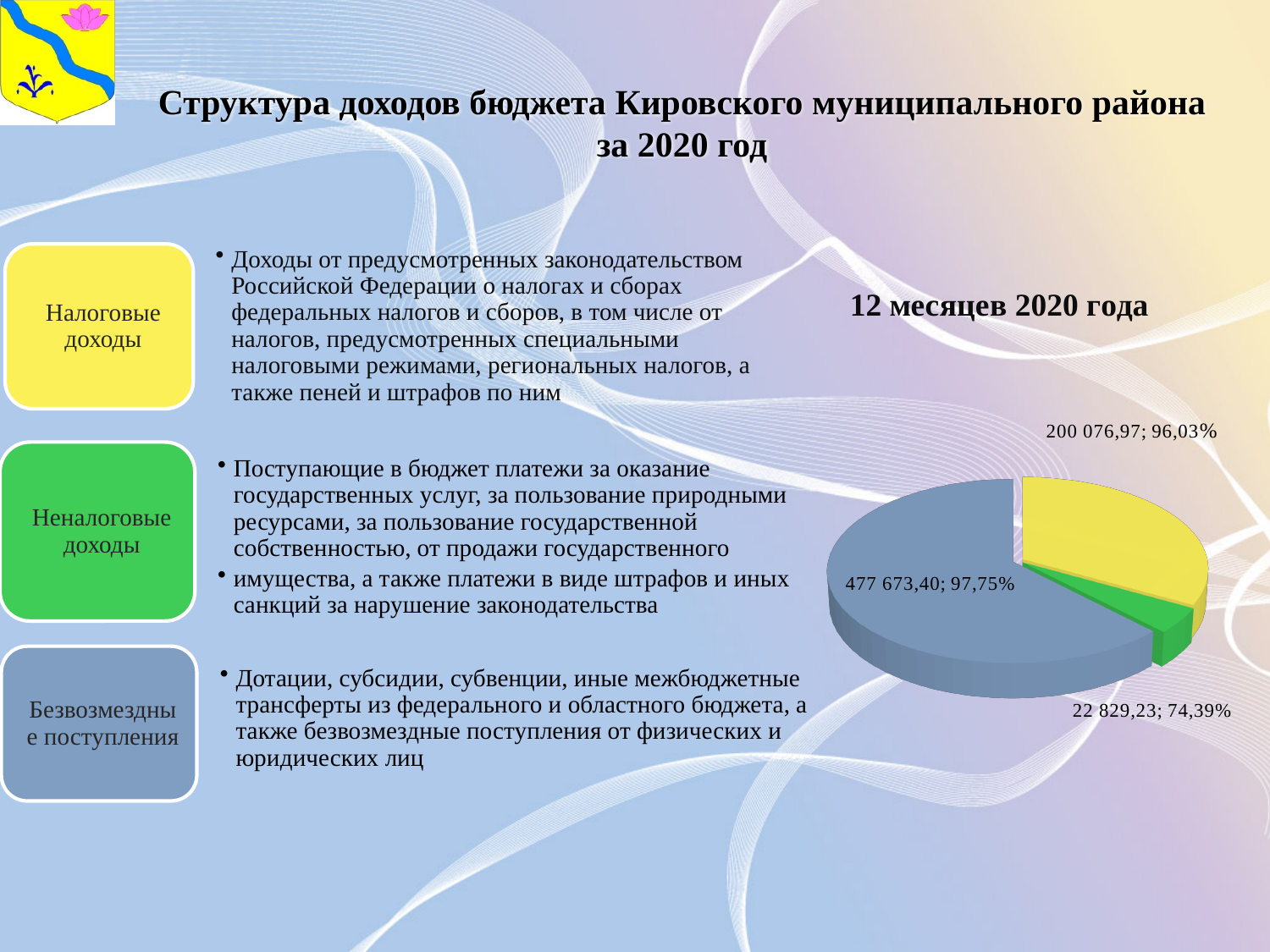
What percentage is printed next to the blue-grey slice of the pie chart? 97,75% Which is larger, the value of the yellow slice or the value of the green slice? the yellow slice What percentage is printed next to the green slice of the pie chart? 74,39% What is the title of the chart on the right of the slide? 12 месяцев 2020 года What value is labelled on the yellow slice of the pie chart? 200 076,97 How many slices does the pie chart have? 3 What is the difference between the values of the blue-grey slice and the yellow slice? 277 596,43 What value is labelled on the blue-grey slice of the pie chart? 477 673,40 What kind of chart is shown on the slide? pie chart Which slice of the pie chart has the largest value? the blue-grey slice (477 673,40) Which slice of the pie chart has the smallest value? the green slice (22 829,23) What value is labelled on the green slice of the pie chart? 22 829,23